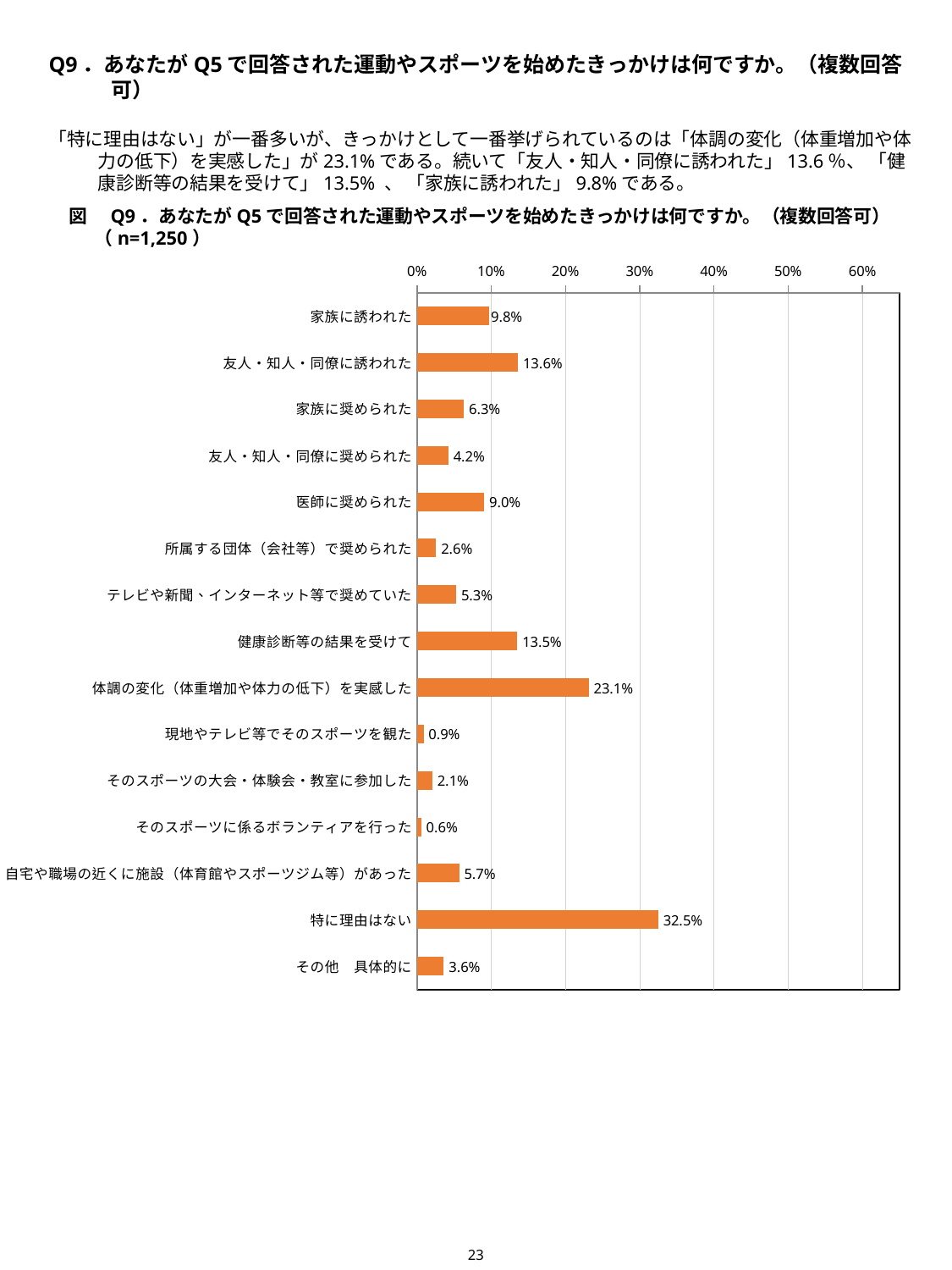
What type of chart is shown on the slide? Bar chart What is the value for 「家族に誘われた」? 9.8% How many categories are plotted in the chart? 15 What is the value for 「体調の変化（体重増加や体力の低下）を実感した」? 23.1% What is the value for 「健康診断等の結果を受けて」? 13.5% Which category has the highest value? 特に理由はない What is the difference between the values for 「特に理由はない」 and 「体調の変化（体重増加や体力の低下）を実感した」? 9.4 percentage points Is the value for 「特に理由はない」 greater or less than 30%? greater Which is larger, the value for 「家族に誘われた」 or 「家族に奨められた」? 家族に誘われた Which category has the lowest value? そのスポーツに係るボランティアを行った What sample size (n) is stated in the chart title? n=1,250 What is the value for 「医師に奨められた」? 9.0%